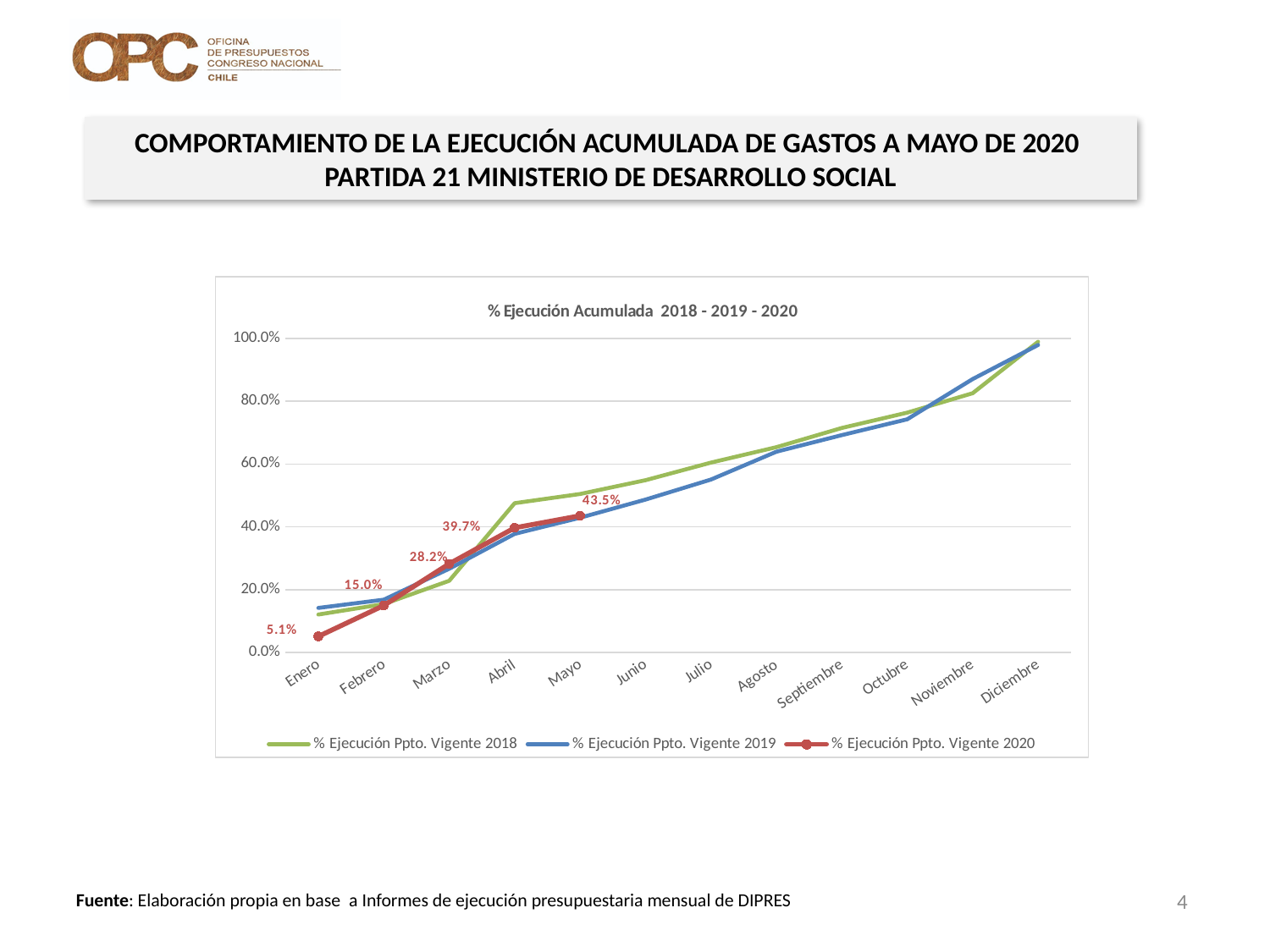
What is the value of % Ejecución Ppto. Vigente 2020 for Marzo? 28.2% How many series does the legend list? 3 Which is larger in Enero: the 2019 series or the 2020 series? % Ejecución Ppto. Vigente 2019 How many months are shown on the x axis? 12 Do the values of the % Ejecución Ppto. Vigente 2020 series rise or fall from Enero to Mayo? rise What is the title of the chart? % Ejecución Acumulada 2018 - 2019 - 2020 What is the value of % Ejecución Ppto. Vigente 2020 for Mayo? 43.5% Is the value for % Ejecución Ppto. Vigente 2018 in Abril greater or less than 40.0%? greater What kind of chart is shown on the slide? line chart What is the difference between the 2020 values for Febrero and Enero? 9.9% What is the difference between the 2020 values for Mayo and Abril? 3.8% What is the value of % Ejecución Ppto. Vigente 2020 for Enero? 5.1%